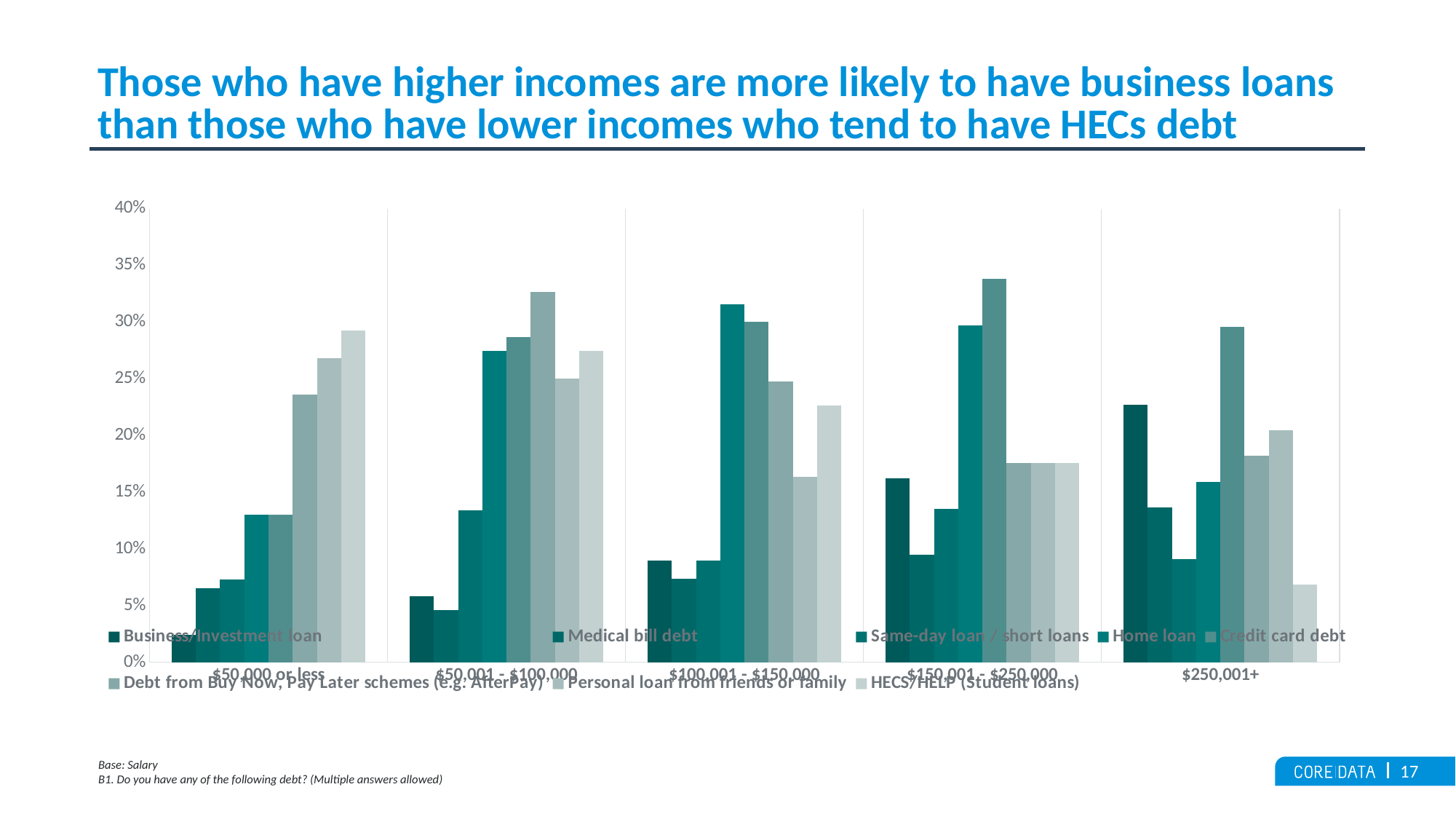
How many series does the legend list? 8 Is the value for Business/Investment loan in the $50,000 or less group greater or less than 5%? less Which debt type has the lowest value in the $250,001+ income group? HECS/HELP (Student loans) Which debt type has the lowest value in the $50,000 or less income group? Business/Investment loan Which debt type has the highest value in the $50,000 or less income group? HECS/HELP (Student loans) Which is larger in the $250,001+ group: Business/Investment loan or HECS/HELP (Student loans)? Business/Investment loan How many income categories are shown on the x axis? 5 Which debt type has the highest value in the $250,001+ income group? Credit card debt What kind of chart is shown on the slide? Bar chart Does the value for HECS/HELP (Student loans) rise or fall as income increases along the x axis? Fall Which income group has the highest value for Business/Investment loan? $250,001+ Is the value for Credit card debt in the $150,001 - $250,000 group greater or less than 30%? greater